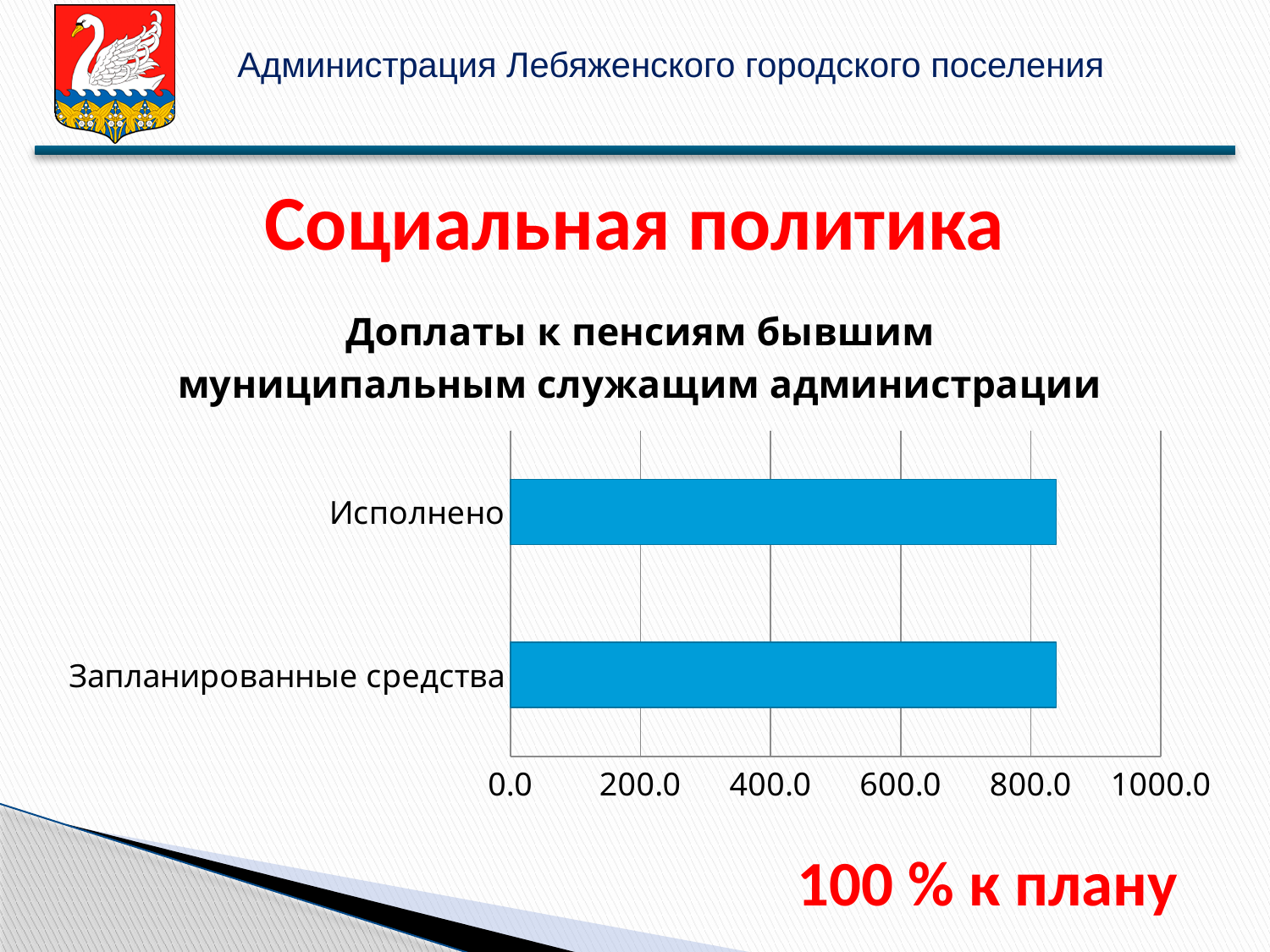
Is the value for Запланированные средства greater or less than 800? greater How many categories are plotted in the chart? 2 What is the title of the chart? Доплаты к пенсиям бывшим муниципальным служащим администрации Is the value for Запланированные средства greater or less than 600? greater Is the value for Исполнено greater or less than 1000? less What is the highest value shown on the horizontal axis of the chart? 1000.0 What kind of chart is shown on the slide? bar chart